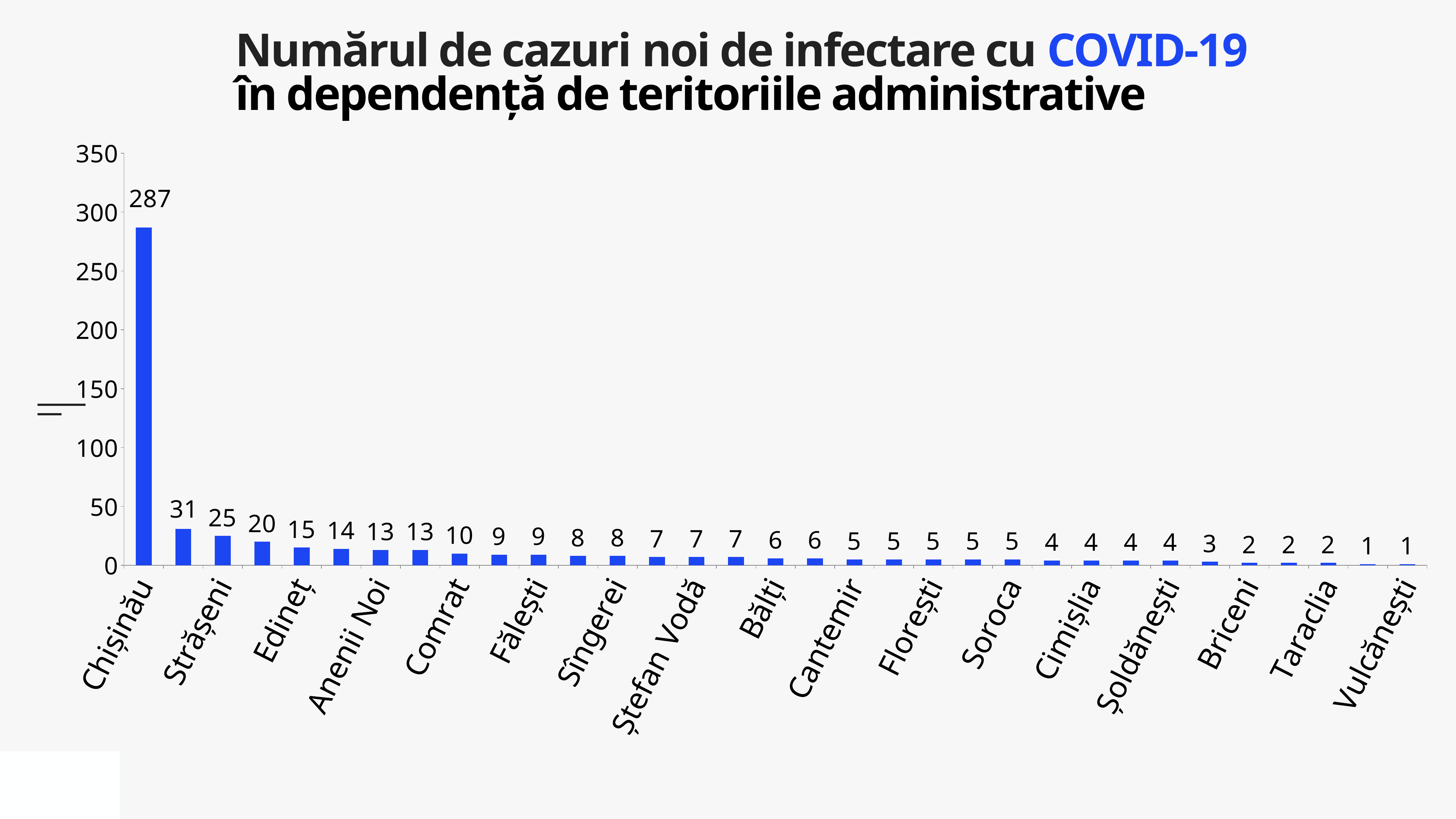
What is the difference between the values for Chișinău and Strășeni? 262 Which is larger, the value for Chișinău or the value for Comrat? Chișinău What is the value for Chișinău? 287 What kind of chart is shown on the slide? bar chart What colour are the bars in the chart? blue Which territory has the highest number of new cases? Chișinău What is the value for Edineț? 15 Do the values rise or fall from left to right along the x axis? fall What is the value for Strășeni? 25 What is the highest value shown on the y axis? 350 What is the value for Vulcănești? 1 Is the value for Chișinău greater or less than 250? greater